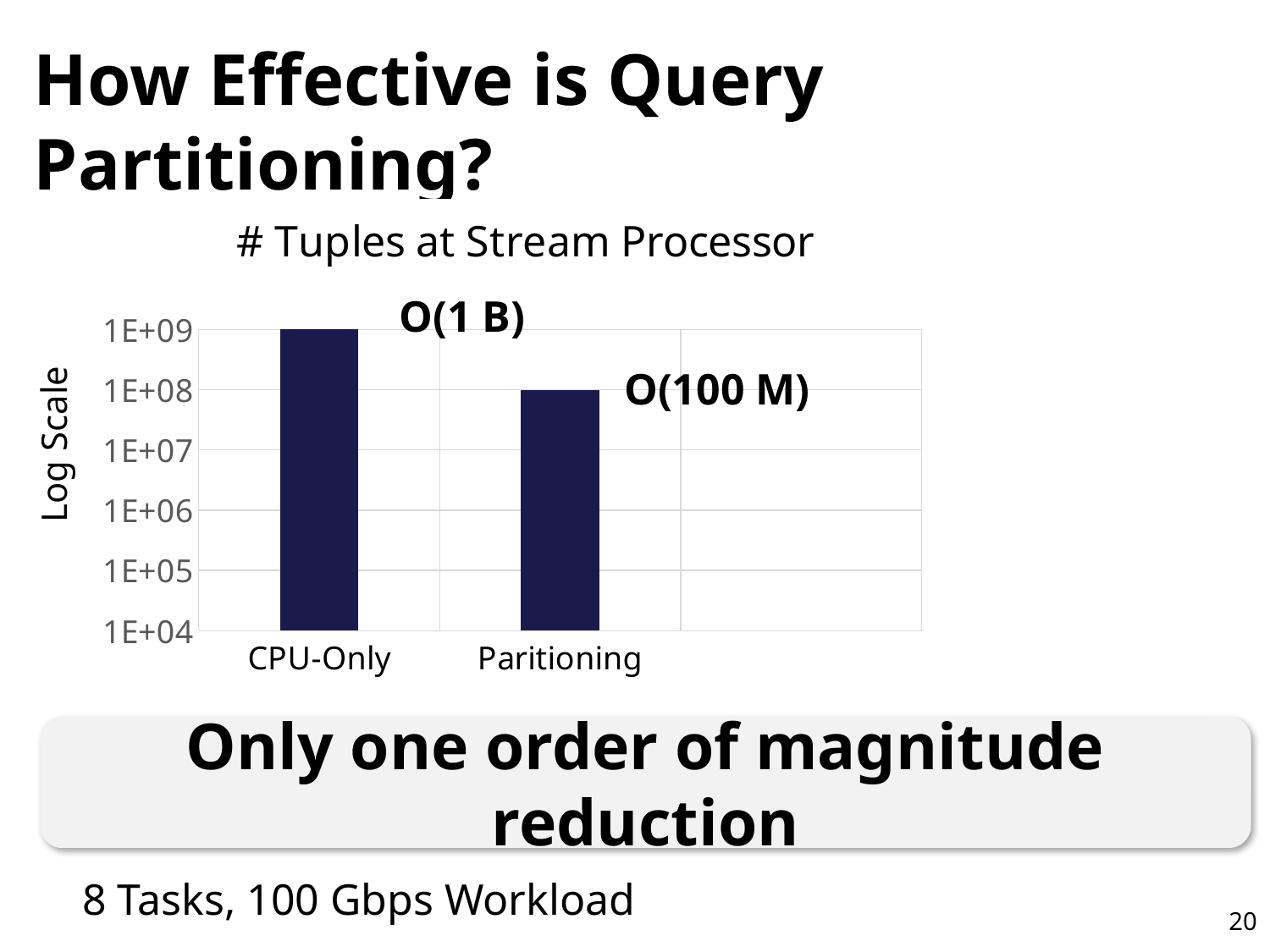
Which axis tick does the CPU-Only bar reach? 1E+09 What is the label on the y axis of the chart? Log Scale How many categories are plotted in the chart? 2 What annotation is printed next to the Paritioning bar? O(100 M) Which is larger, the value for CPU-Only or the value for Paritioning? CPU-Only Which category has the highest number of tuples at the stream processor? CPU-Only What kind of chart is shown on the slide? bar chart What annotation is printed next to the CPU-Only bar? O(1 B) What is the title of the chart? # Tuples at Stream Processor Which axis tick does the Paritioning bar reach? 1E+08 Which category has the lowest number of tuples at the stream processor? Paritioning Is the value for Paritioning greater or less than 1E+07? greater